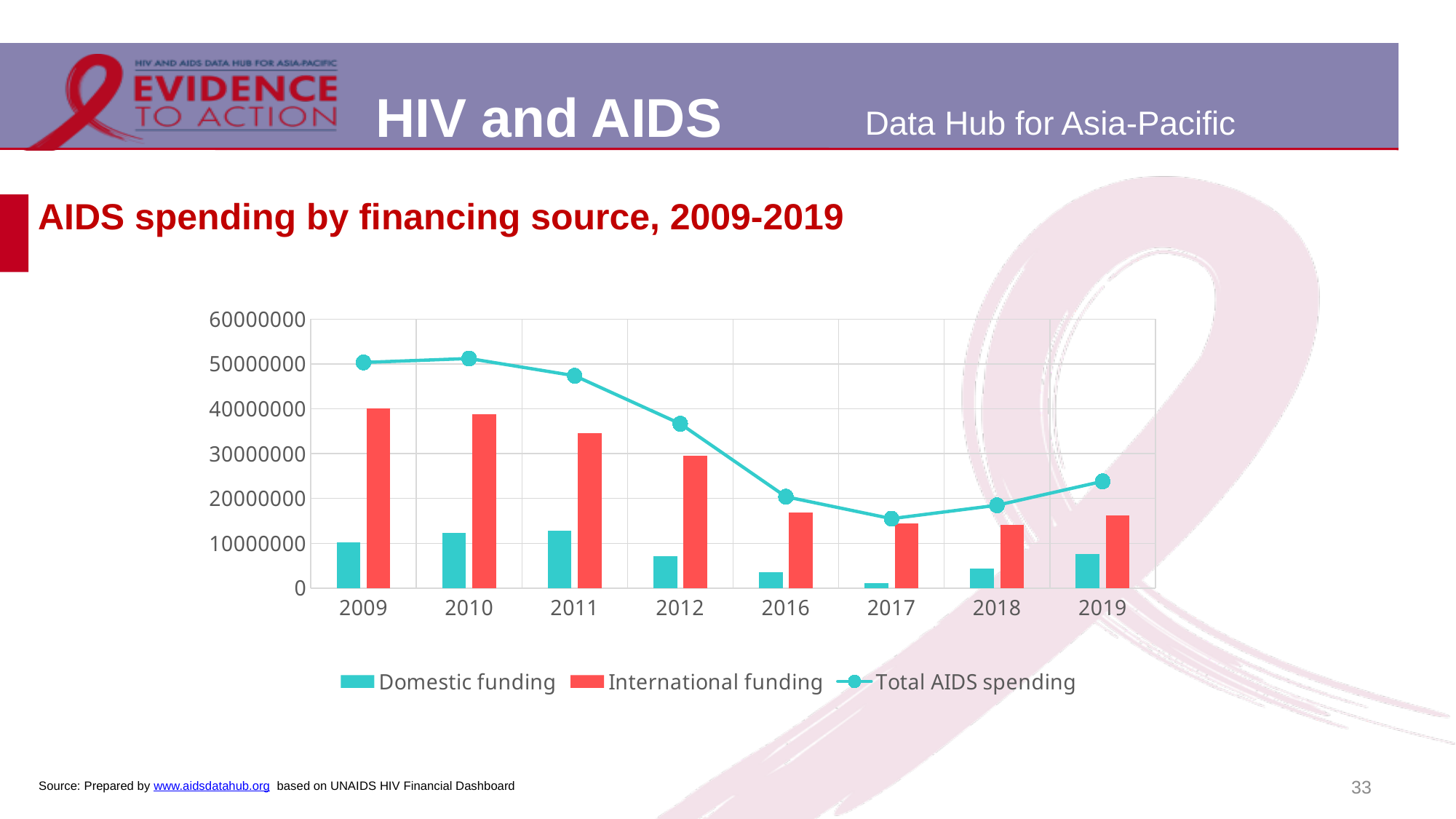
How many series does the chart legend list? 3 Which series is plotted as a line with markers? Total AIDS spending Does Total AIDS spending rise or fall between 2010 and 2017? fall In which year is Total AIDS spending lowest? 2017 Is the value for Total AIDS spending in 2012 greater or less than 30000000? greater Is the value for Domestic funding in 2017 greater or less than 10000000? less Which is larger: International funding in 2012 or International funding in 2016? International funding in 2012 What kind of chart is shown on the slide? A combined bar and line chart What is the title of the chart on the slide? AIDS spending by financing source, 2009-2019 In which year is Domestic funding lowest? 2017 Is the value for International funding in 2009 greater or less than 30000000? greater How many years are shown on the x axis of the chart? 8